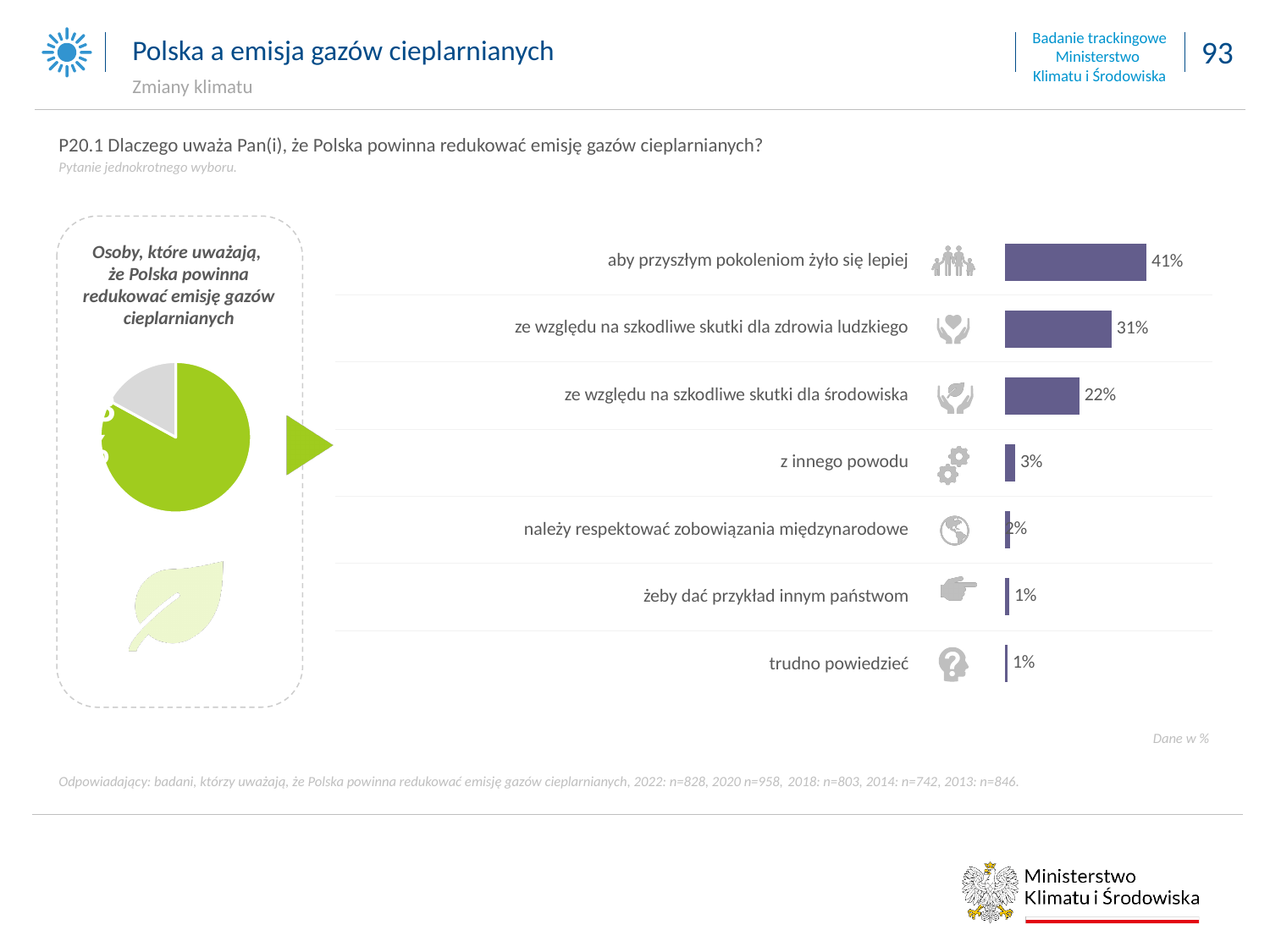
What type of chart is used on the right side of the slide to show the reasons? bar chart In the bar chart, what is the value for "trudno powiedzieć"? 1% In the bar chart, what percentage of respondents chose "aby przyszłym pokoleniom żyło się lepiej"? 41% In the bar chart, what is the value for "ze względu na szkodliwe skutki dla zdrowia ludzkiego"? 31% What type of chart is shown on the left side of the slide inside the dashed box? pie chart In the bar chart, what is the value for "ze względu na szkodliwe skutki dla środowiska"? 22% In the bar chart, which is larger: the value for "z innego powodu" or the value for "należy respektować zobowiązania międzynarodowe"? z innego powodu How many categories (reasons) are shown in the bar chart? 7 In the bar chart, what is the difference between the values for "aby przyszłym pokoleniom żyło się lepiej" and "ze względu na szkodliwe skutki dla zdrowia ludzkiego"? 10% In the bar chart, what is the difference between the values for "ze względu na szkodliwe skutki dla zdrowia ludzkiego" and "ze względu na szkodliwe skutki dla środowiska"? 9% In the bar chart, which reason has the highest share of responses? aby przyszłym pokoleniom żyło się lepiej In the bar chart, what is the value for "z innego powodu"? 3%